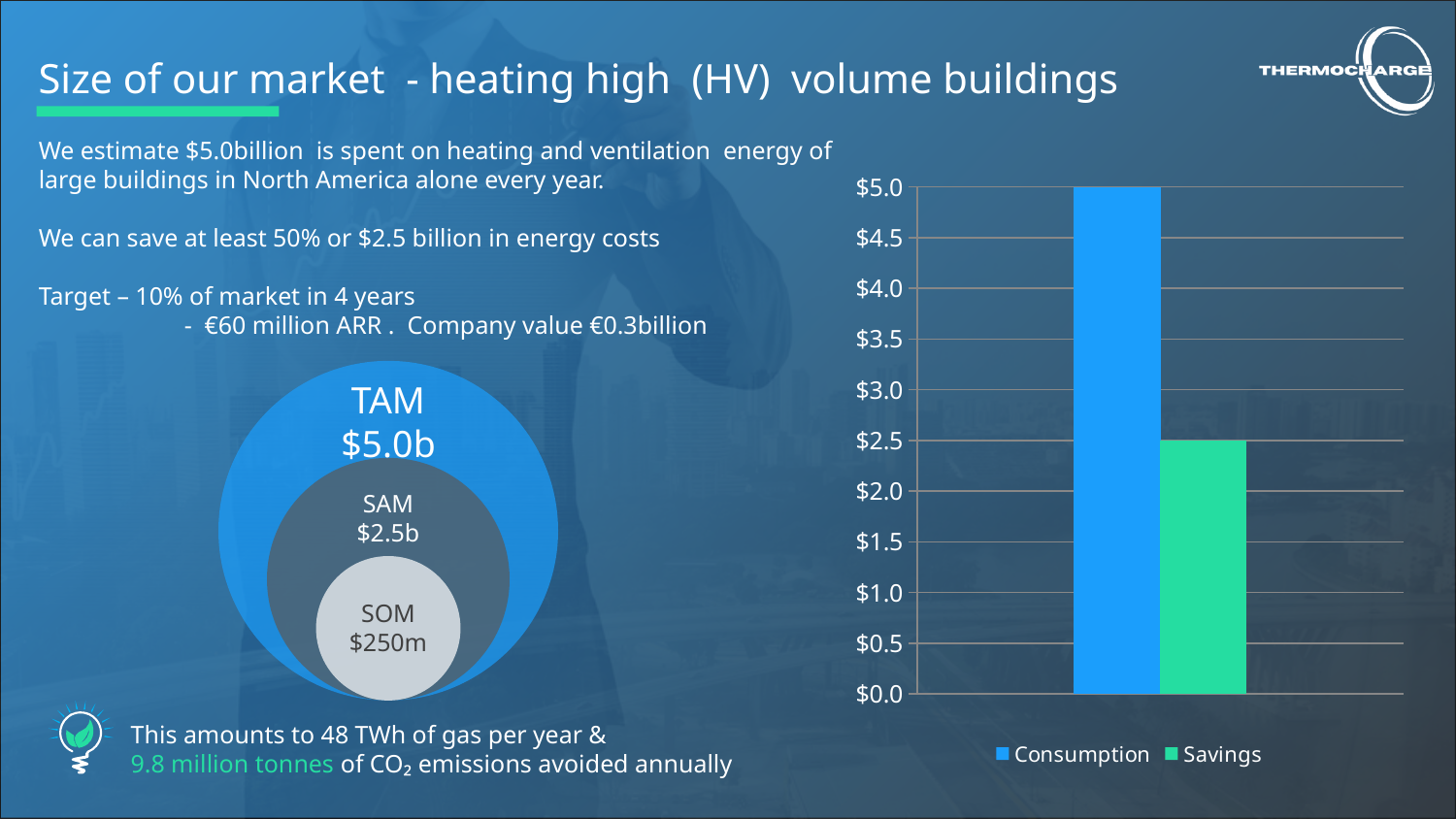
Is the value of the Consumption bar greater or less than $4.0? greater What value does the Consumption bar reach on the bar chart? $5.0 Is the value of the Savings bar greater or less than $3.0? less What colour is the Savings series on the bar chart? green Which series has the shortest bar on the bar chart? Savings Which series has the tallest bar on the bar chart? Consumption What is the difference between the Consumption bar and the Savings bar on the bar chart? $2.5 How many bars are plotted on the bar chart? 2 What kind of chart is shown on the right side of the slide? bar chart What value does the Savings bar reach on the bar chart? $2.5 On the bar chart, is the Consumption bar or the Savings bar larger? Consumption How many series does the legend of the bar chart list? 2